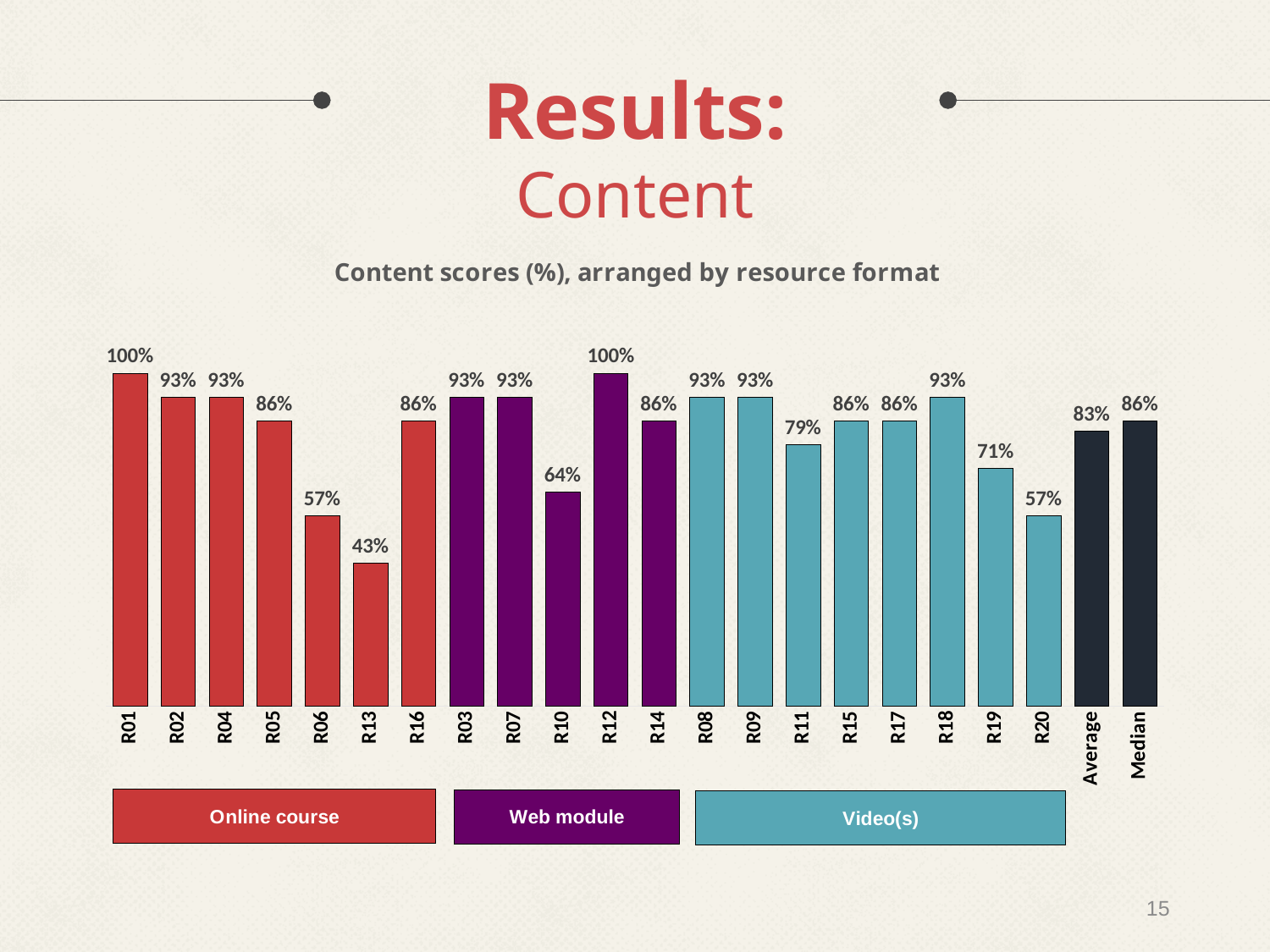
Which has a higher content score, R11 or R19? R11 What is the content score for R13? 43% What is the content score for R20? 57% How many individual resources (excluding Average and Median) are plotted in the chart? 20 What is the difference between the content scores of R01 and R13? 57 percentage points Which resource format group does R12 belong to? Web module What is the content score for R10? 64% What is the value of the Median bar? 86% What is the difference between the content scores of R11 and R20? 22 percentage points Which resource has the lowest content score? R13 What kind of chart is shown on the slide? Bar chart What is the value of the Average bar? 83%